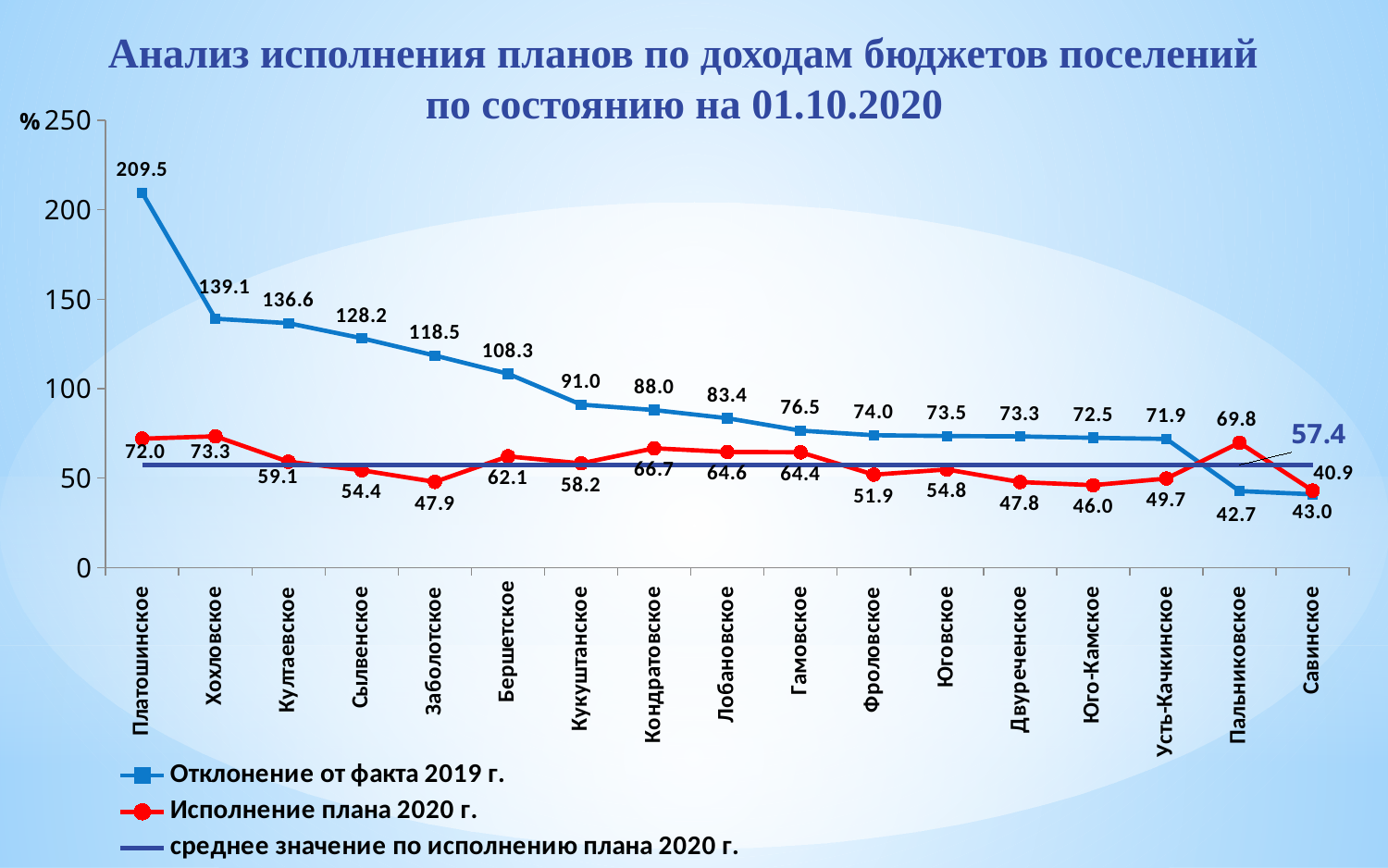
Which settlement has the lowest value in the 'Исполнение плана 2020 г.' series? Савинское What is the value of the 'Исполнение плана 2020 г.' series for Пальниковское? 69.8 Does the 'Отклонение от факта 2019 г.' series rise or fall from left to right along the x axis? fall Is the 'Отклонение от факта 2019 г.' value for Бершетское greater or less than 100? greater How many settlements are shown on the x axis? 17 Which settlement has the highest value in the 'Отклонение от факта 2019 г.' series? Платошинское What is the value of the 'Исполнение плана 2020 г.' series for Заболотское? 47.9 In the 'Исполнение плана 2020 г.' series, which is larger: Хохловское or Култаевское? Хохловское What is the value of the 'Отклонение от факта 2019 г.' series for Платошинское? 209.5 What is the difference between the 'Отклонение от факта 2019 г.' values for Платошинское and Хохловское? 70.4 How many series does the legend list? 3 What kind of chart is shown on the slide? line chart